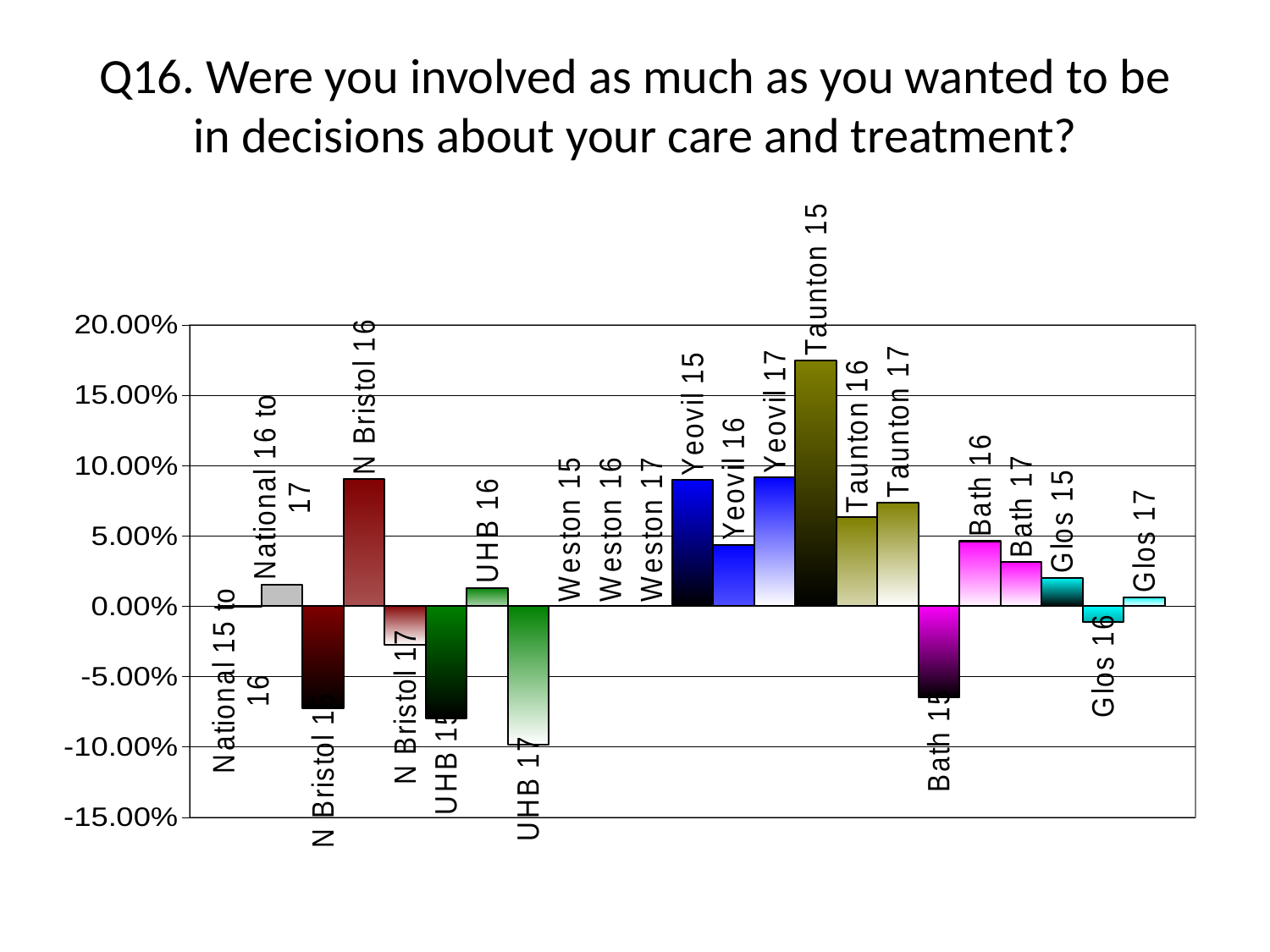
What is the title of the slide? Q16. Were you involved as much as you wanted to be in decisions about your care and treatment? Which category has the lowest value? UHB 17 Which category has the highest value? Taunton 15 Is the value for Yeovil 16 greater or less than 5.00%? less Is the value for N Bristol 16 greater or less than 10.00%? less Is the value for Bath 15 greater or less than -5.00%? less Which is larger, the value for Taunton 15 or the value for Taunton 16? Taunton 15 How many categories are plotted on the chart? 23 What kind of chart is shown on the slide? bar chart Which is larger, the value for N Bristol 16 or the value for N Bristol 17? N Bristol 16